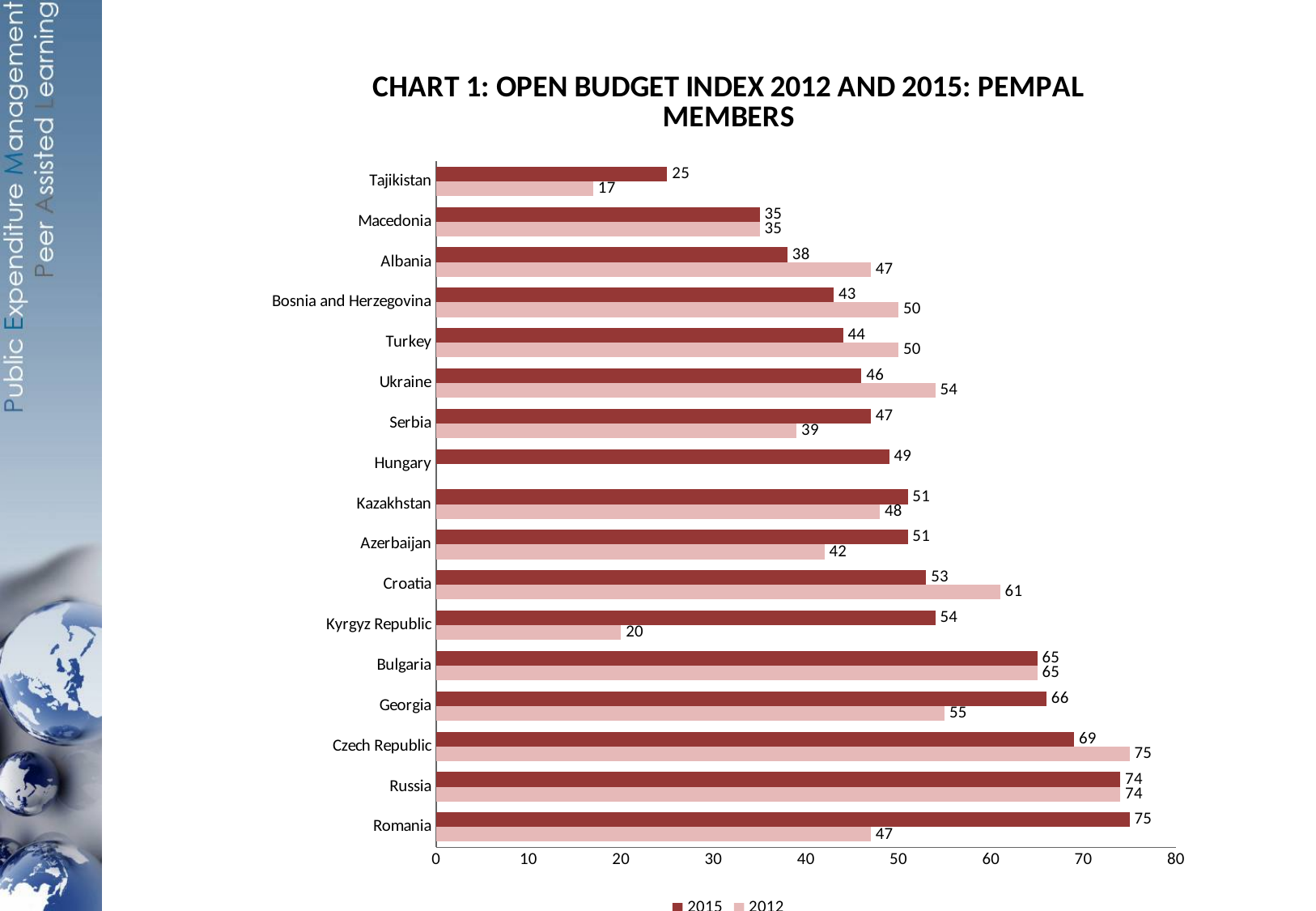
What is the 2012 value for Czech Republic? 75 How many series does the legend list? 2 What is the difference between the 2015 and 2012 values for Kyrgyz Republic? 34 What is the difference between the 2012 and 2015 values for Croatia? 8 What is the 2015 Open Budget Index value for Romania? 75 Which country has the highest 2015 value? Romania How many countries are shown on the chart? 17 Which country has the lowest 2015 value? Tajikistan Is the 2015 value for Georgia greater or less than 60? greater What kind of chart is shown on the slide? Bar chart What is the 2012 Open Budget Index value for Kyrgyz Republic? 20 Which is larger for Ukraine, the 2015 value or the 2012 value? 2012